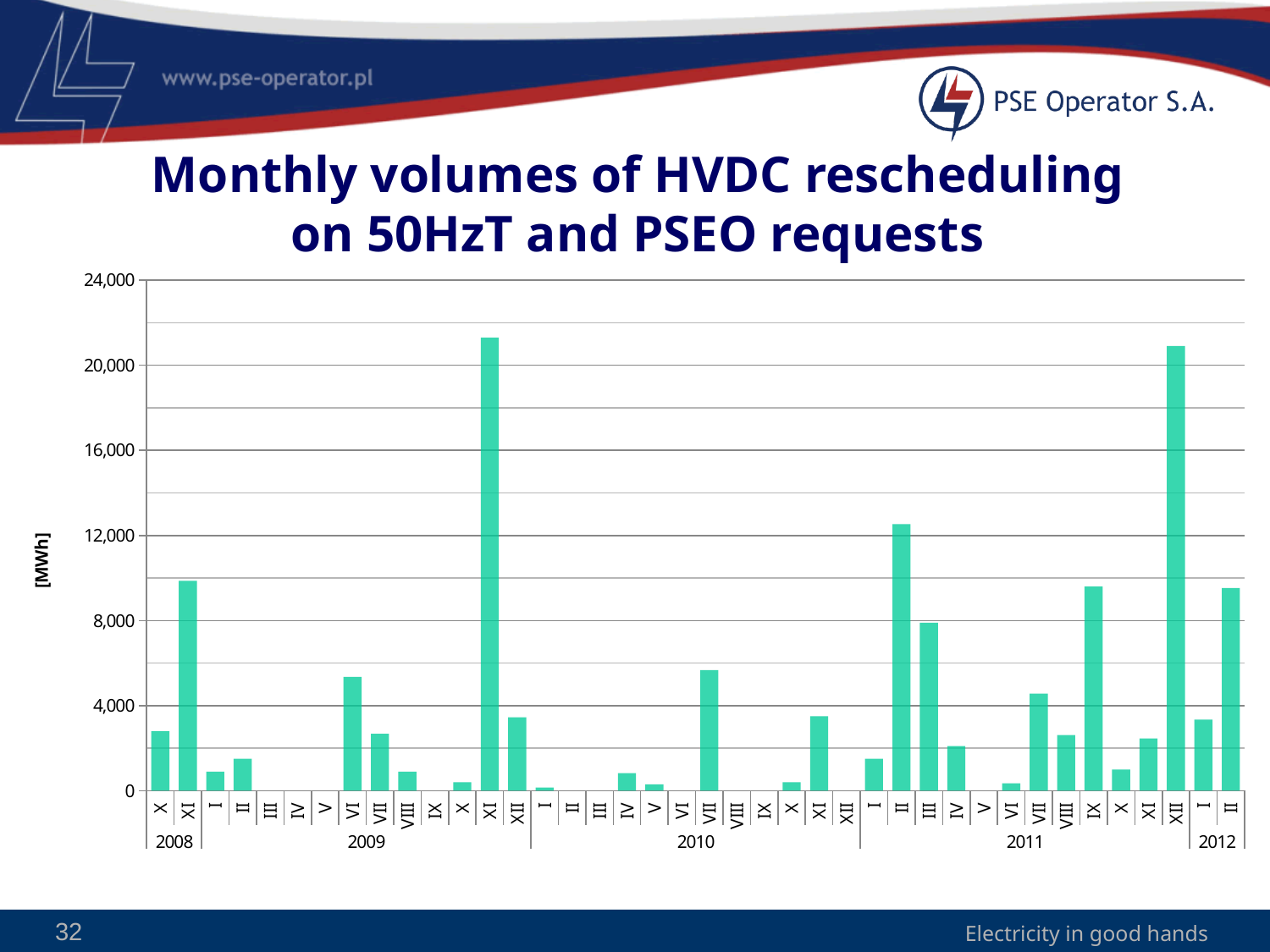
Is the value for XI 2009 greater or less than 20,000? greater Which is larger, the value for XII 2011 or the value for II 2012? XII 2011 Which is larger, the value for II 2011 or the value for III 2011? II 2011 What is the highest value shown on the vertical axis? 24,000 How many years are labelled along the x axis? 5 Is the value for IX 2011 greater or less than 8,000? greater Is the value for XI 2008 greater or less than 8,000? greater What kind of chart is shown on the slide? bar chart What unit is shown on the vertical axis label? [MWh]